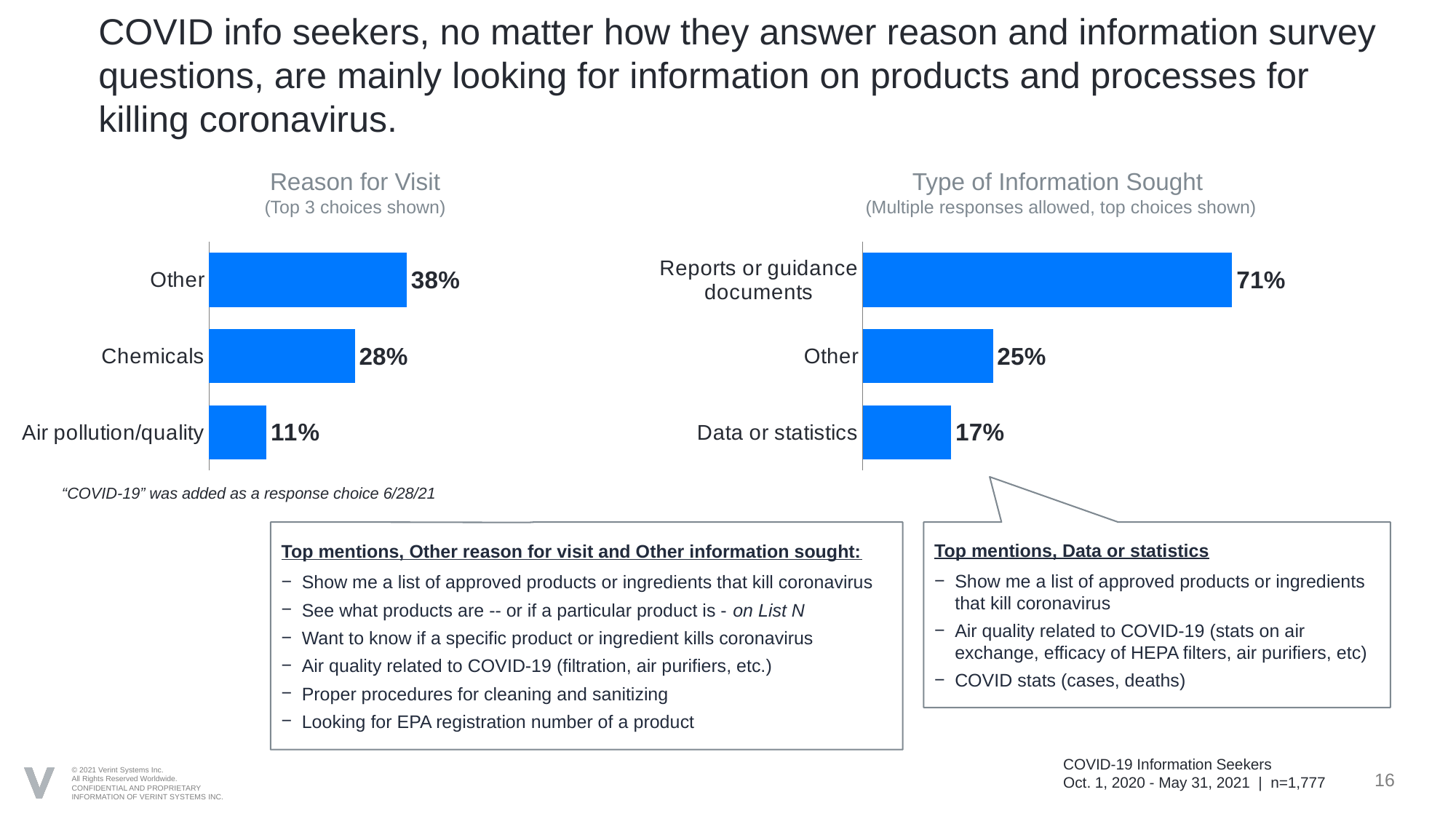
In the "Type of Information Sought" chart, what is the value for Reports or guidance documents? 71% In the "Reason for Visit" chart, what is the value for Air pollution/quality? 11% In the "Type of Information Sought" chart, what is the difference between the values for Reports or guidance documents and Other? 46% In the "Type of Information Sought" chart, what is the value for Data or statistics? 17% What is the subtitle shown under the "Reason for Visit" chart title? (Top 3 choices shown) In the "Reason for Visit" chart, what is the difference between the values for Other and Chemicals? 10% In the "Reason for Visit" chart, which category has the highest value? Other How many categories are shown in the "Reason for Visit" chart? 3 What kind of chart is the "Type of Information Sought" chart? Bar chart In the "Reason for Visit" chart, what is the value for Chemicals? 28% In the "Type of Information Sought" chart, which category has the lowest value? Data or statistics In the "Type of Information Sought" chart, which is larger, the value for Other or the value for Data or statistics? Other